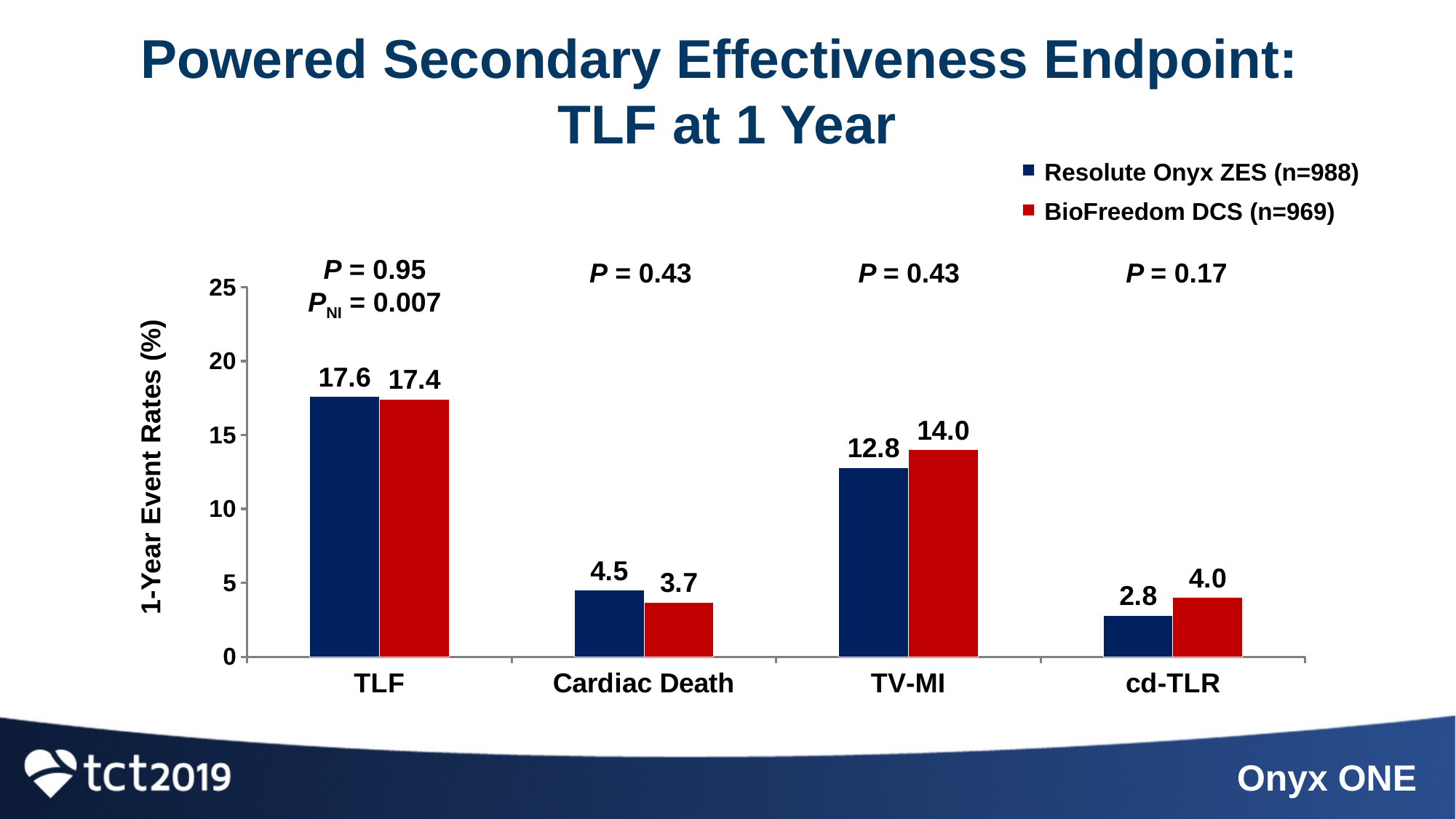
Which category has the highest event rate for BioFreedom DCS? TLF For cd-TLR, which series has the larger event rate, Resolute Onyx ZES or BioFreedom DCS? BioFreedom DCS Which category has the lowest event rate for Resolute Onyx ZES? cd-TLR What is the 1-year event rate for Resolute Onyx ZES for cd-TLR? 2.8 What is the 1-year event rate for BioFreedom DCS for TV-MI? 14.0 What is the 1-year event rate for BioFreedom DCS for Cardiac Death? 3.7 What is the difference between the Resolute Onyx ZES and BioFreedom DCS event rates for TV-MI? 1.2 How many series does the legend list? 2 How many categories are shown on the x axis? 4 What is the 1-year event rate for Resolute Onyx ZES for TLF? 17.6 What kind of chart is shown on the slide? Bar chart What is the P value shown above the TV-MI bars? P = 0.43